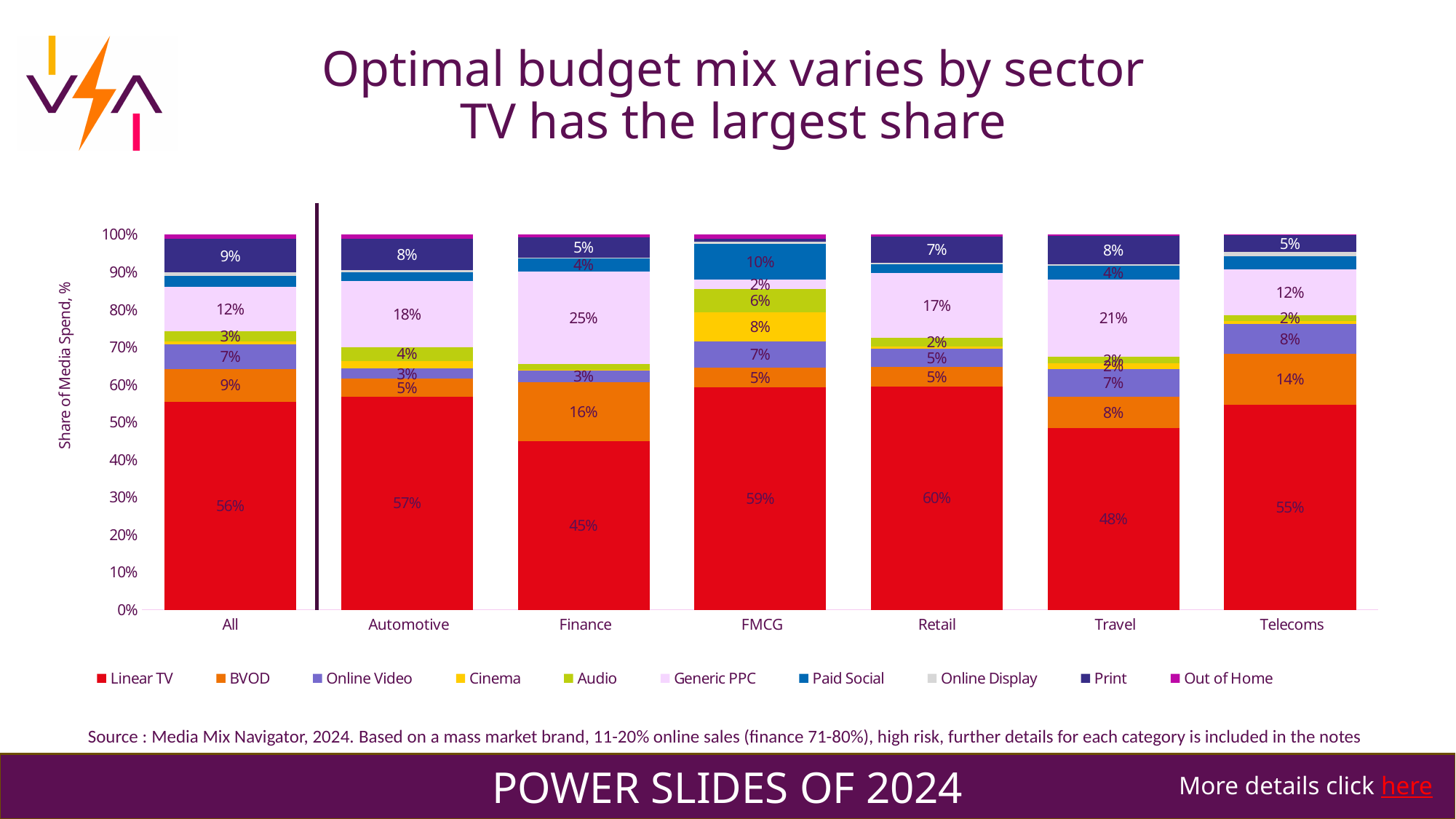
How many sectors (categories) are shown on the x axis? 7 How many media channels does the legend list? 10 What is the Paid Social share of media spend for FMCG? 10% What is the Generic PPC share of media spend for Travel? 21% What kind of chart is shown on the slide? Stacked bar chart How many percentage points higher is the Generic PPC share for Finance than for All? 13 percentage points Which has a larger BVOD share of media spend, Finance or Automotive? Finance What is the Linear TV share of media spend for Finance? 45% Which sector has the highest Linear TV share of media spend? Retail Which sector has the lowest Linear TV share of media spend? Finance Is the Linear TV share for Travel greater or less than 50%? less What is the BVOD share of media spend for Telecoms? 14%